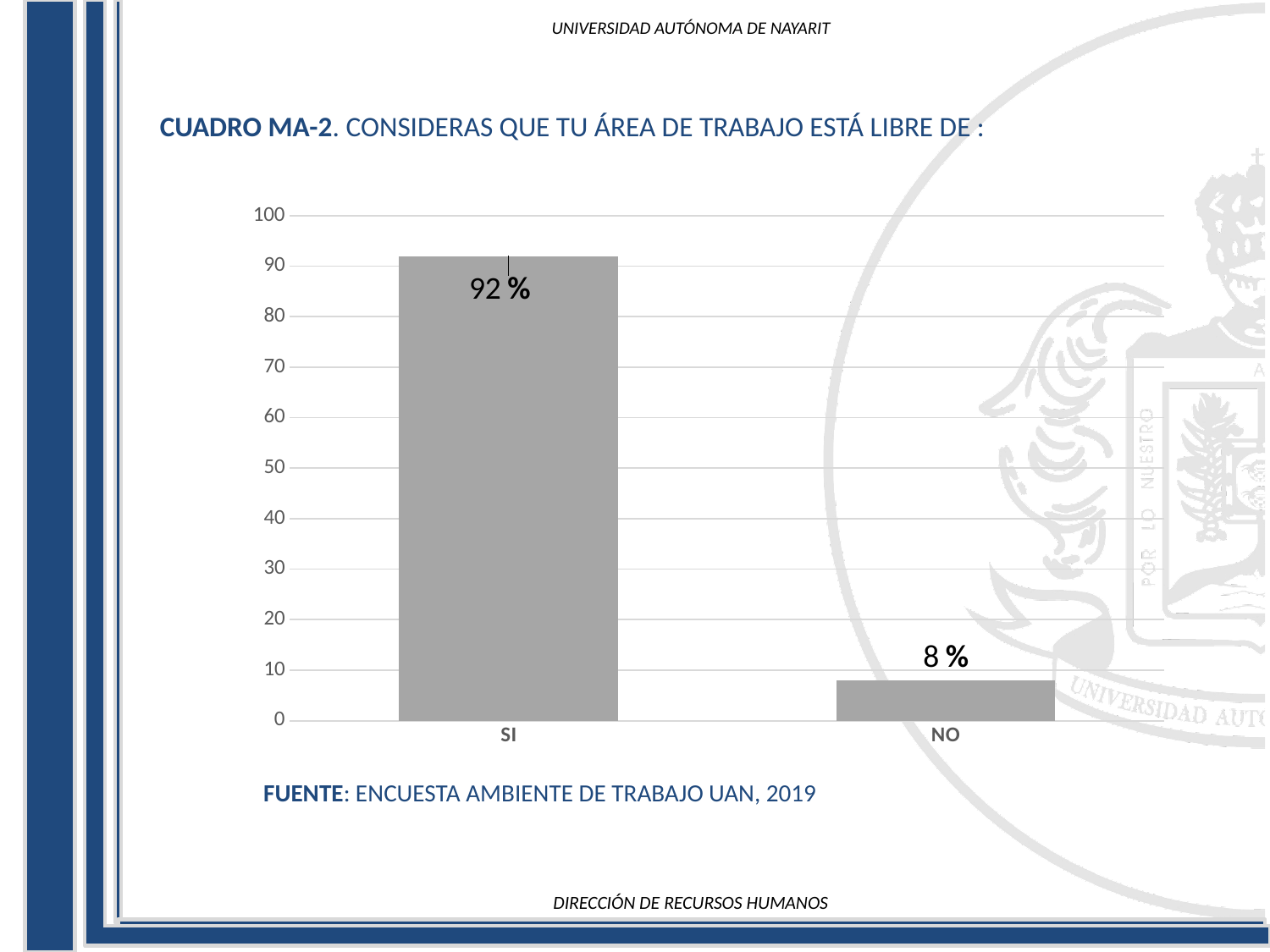
What kind of chart is shown on the slide? bar chart What is the value for SI? 92 % Which category has the lowest value? NO What is the source cited below the chart? ENCUESTA AMBIENTE DE TRABAJO UAN, 2019 How many categories are shown on the x axis? 2 Which category has the highest value? SI What is the difference between the values for SI and NO? 84 % Is the value for NO greater or less than 10? less What is the value for NO? 8 % Which is larger, the value for SI or the value for NO? SI What is the title of the chart? CUADRO MA-2. CONSIDERAS QUE TU ÁREA DE TRABAJO ESTÁ LIBRE DE : Is the value for SI greater or less than 90? greater